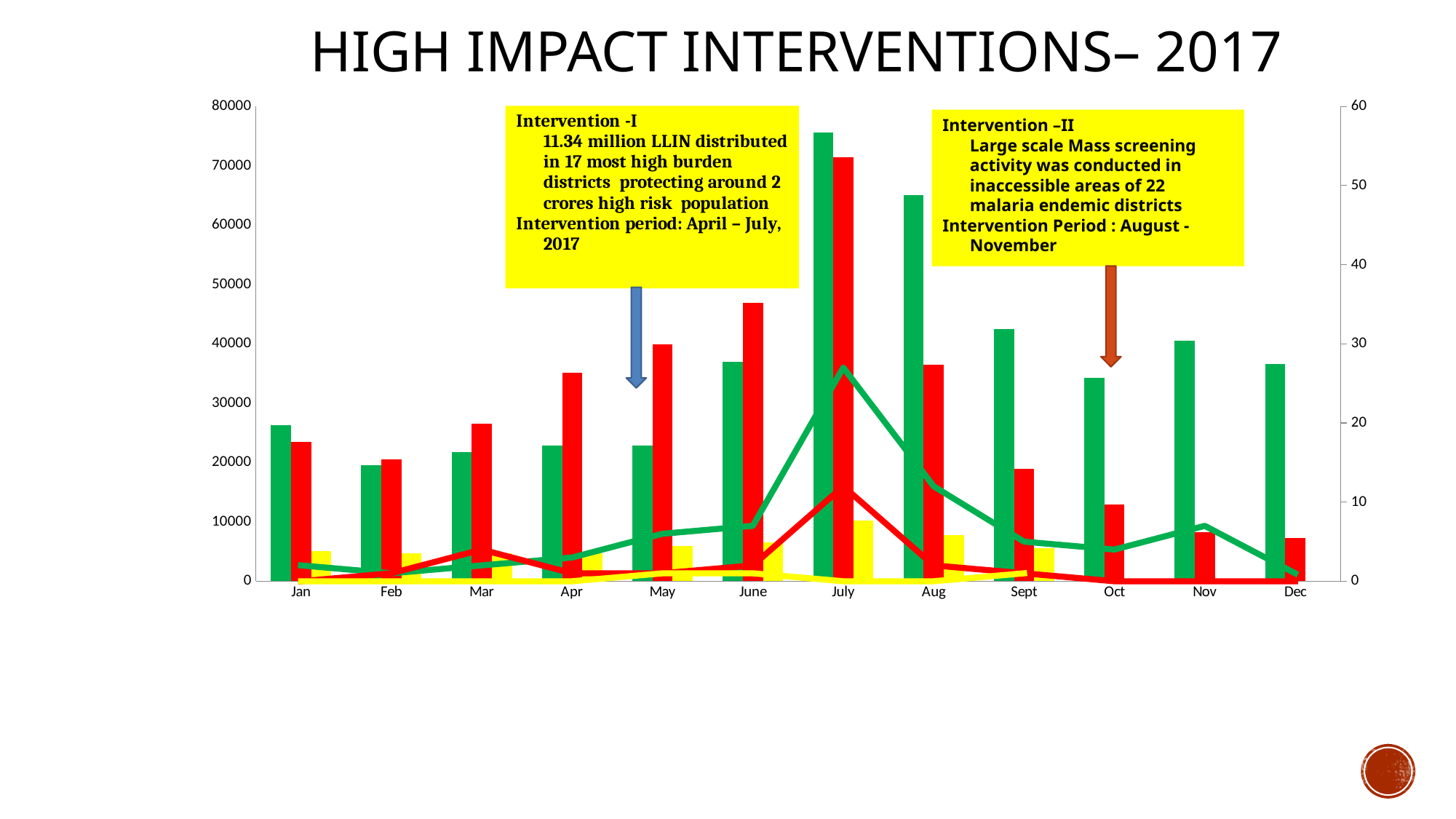
What kind of chart is shown on the slide? A combination bar and line chart In Sept, which bar is taller, the green bar or the red bar? The green bar Is the green bar for Aug greater or less than 60000 on the left axis? greater Is the green bar for July greater or less than 70000 on the left axis? greater How many months are shown along the x axis of the chart? 12 Is the green bar for Dec greater or less than 40000 on the left axis? less In which month is the red bar the tallest? July In which month is the green bar the tallest? July What is the title of the slide containing the chart? HIGH IMPACT INTERVENTIONS– 2017 Do the red bars rise or fall from July to Dec? Fall In which month is the green bar the shortest? Feb